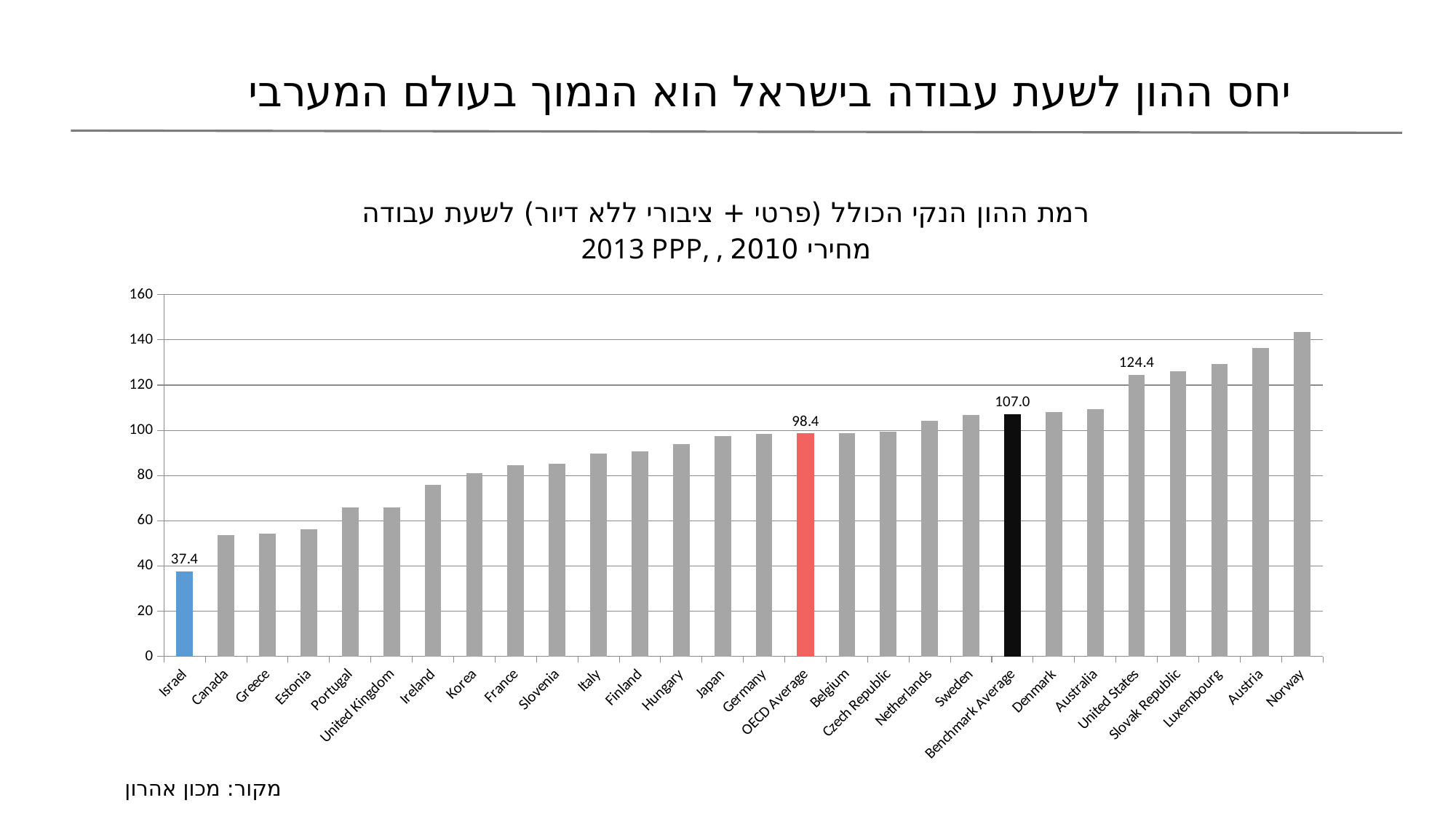
What is the value for OECD Average? 98.4 Do the values generally rise or fall from left to right along the x axis? rise What is the difference between the Benchmark Average and the OECD Average? 8.6 How many bars are shown in the chart? 28 What is the difference between the United States value and the Israel value? 87.0 Which country has the lowest bar? Israel What is the value for Israel? 37.4 What is the value for United States? 124.4 Is the value for Norway greater or less than 140? greater Which country has the highest bar? Norway What is the value for Benchmark Average? 107.0 Which is larger, the value for Canada or the value for Japan? Japan